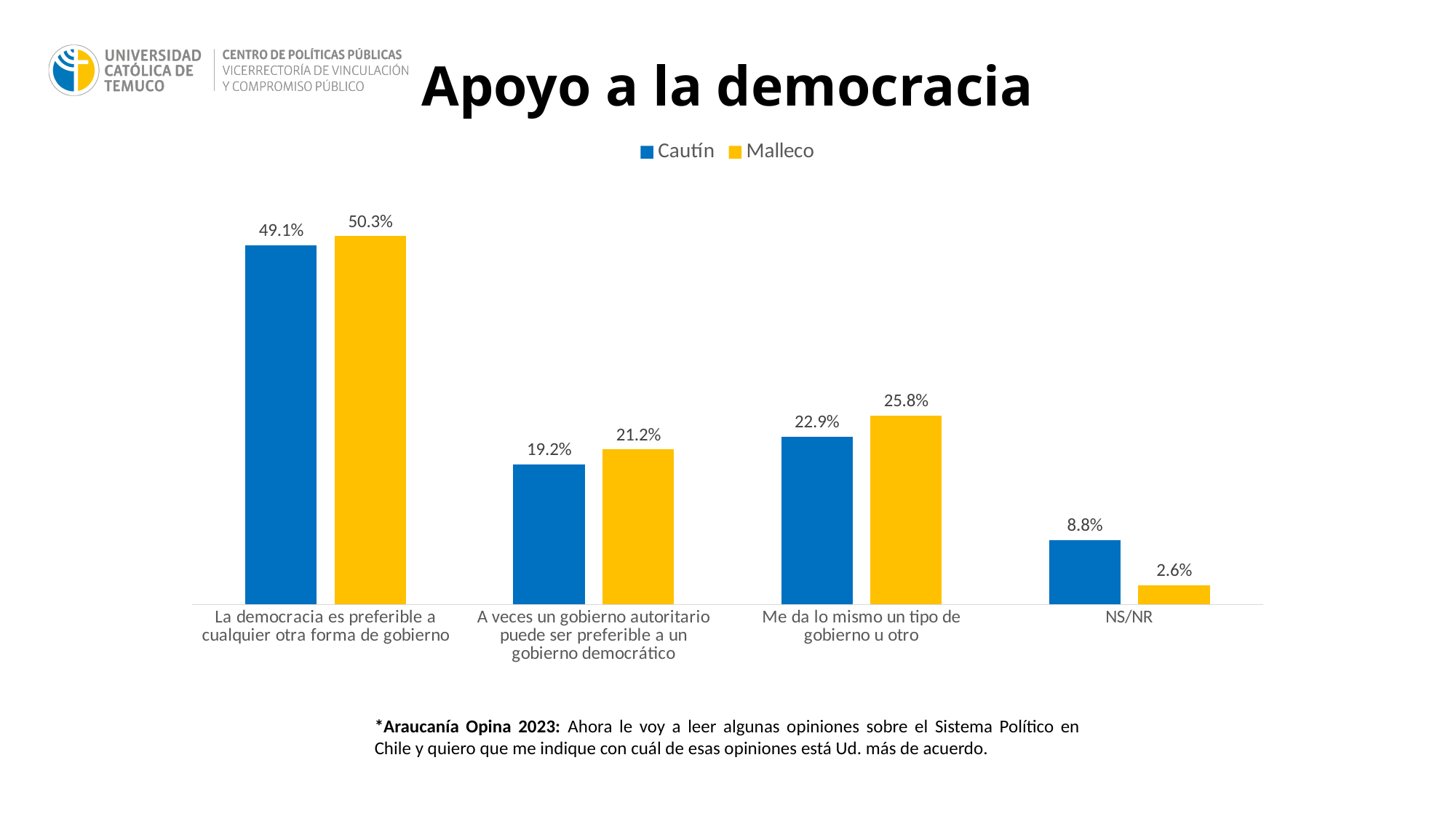
How many categories are shown on the x axis? 4 What is the difference between the Malleco and Cautín values for "Me da lo mismo un tipo de gobierno u otro"? 2.9% What is the Malleco value for "Me da lo mismo un tipo de gobierno u otro"? 25.8% What is the Cautín value for "La democracia es preferible a cualquier otra forma de gobierno"? 49.1% What is the Cautín value for "A veces un gobierno autoritario puede ser preferible a un gobierno democrático"? 19.2% What is the Malleco value for "NS/NR"? 2.6% Which category has the highest Malleco value? La democracia es preferible a cualquier otra forma de gobierno Which category has the lowest Cautín value? NS/NR What is the difference between the Cautín and Malleco values for "NS/NR"? 6.2% How many series does the legend list? 2 What kind of chart is shown on the slide? Bar chart For "A veces un gobierno autoritario puede ser preferible a un gobierno democrático", which is larger, Cautín or Malleco? Malleco